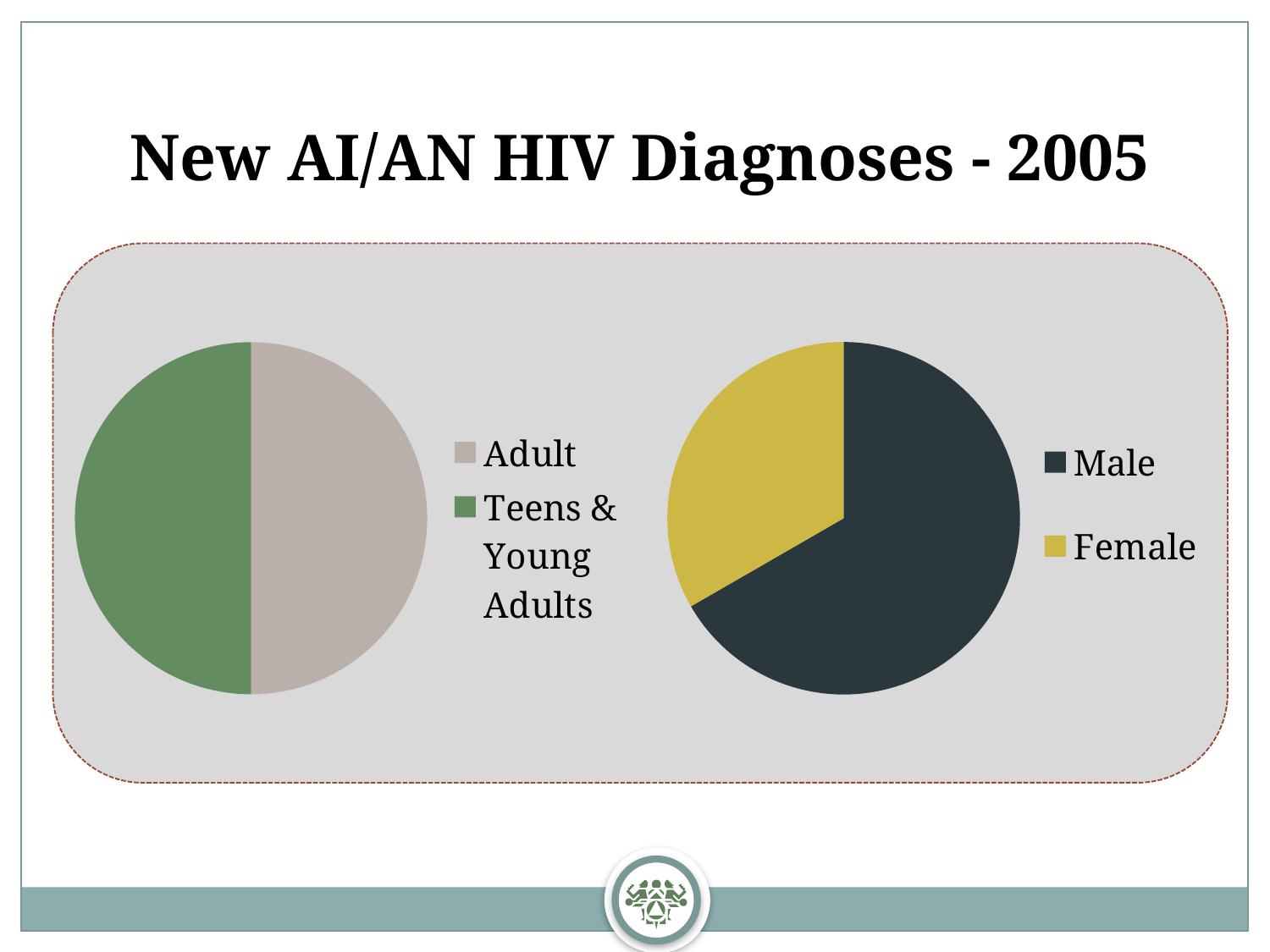
What kind of chart is the right chart on the slide? pie chart In the right pie chart, which slice is larger, Male or Female? Male What kind of chart is the left chart on the slide? pie chart In the right pie chart, which category has the smallest slice? Female In the right pie chart, which category has the largest slice? Male In the left pie chart, what colour represents Teens & Young Adults? green How many slices does the right pie chart have? 2 How many entries does the legend of the left pie chart list? 2 What is the title of the slide containing the two pie charts? New AI/AN HIV Diagnoses - 2005 How many slices does the left pie chart have? 2 How many entries does the legend of the right pie chart list? 2